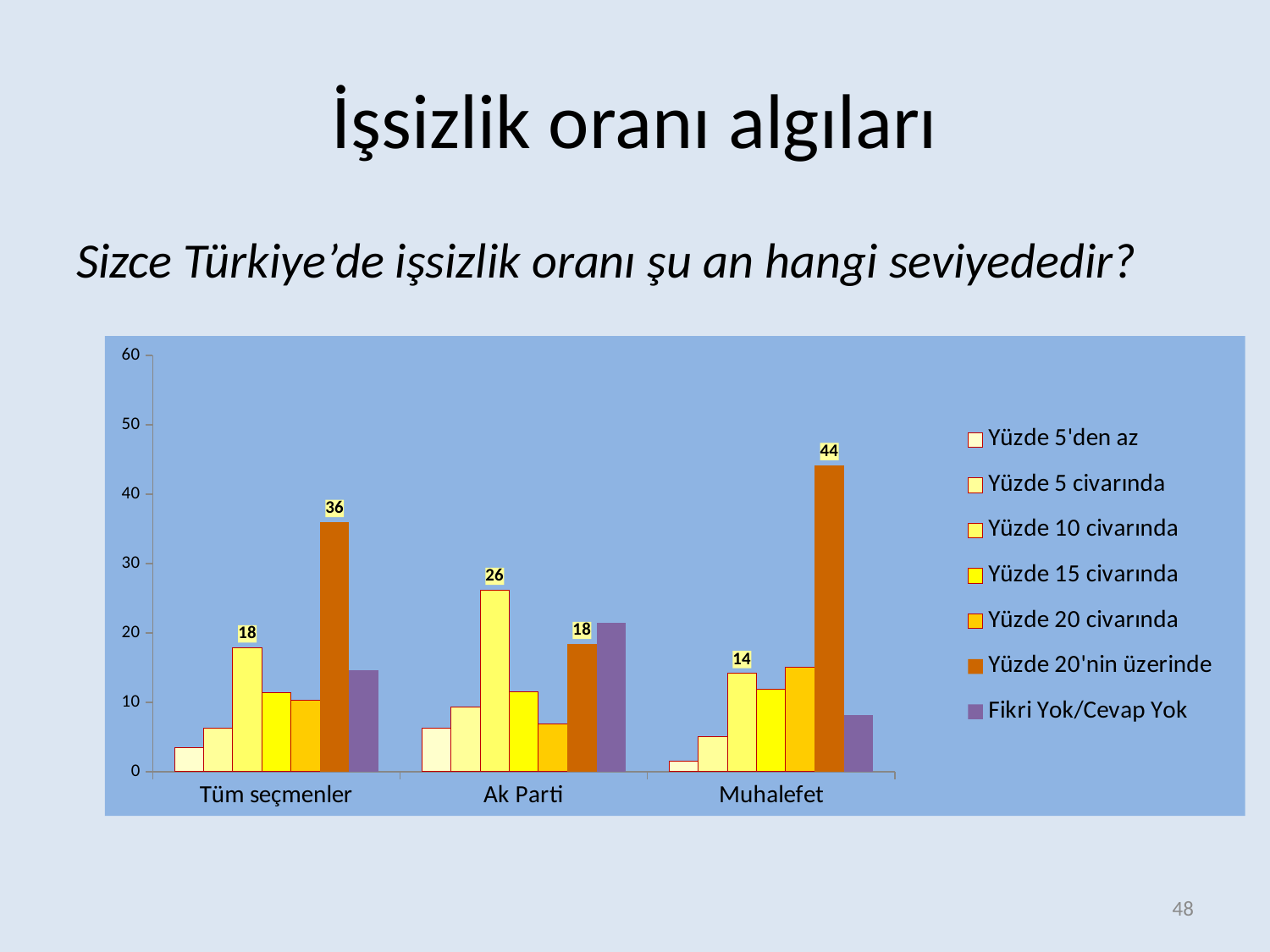
Which series is shown in purple in the legend? Fikri Yok/Cevap Yok What is the difference between the 'Yüzde 20'nin üzerinde' values for Muhalefet and Tüm seçmenler? 8 How many categories are shown on the x axis? 3 Which category has the lowest value for 'Yüzde 10 civarında'? Muhalefet Which category has the highest value for 'Yüzde 20'nin üzerinde'? Muhalefet In the Ak Parti group, which is larger: 'Yüzde 10 civarında' or 'Yüzde 20'nin üzerinde'? Yüzde 10 civarında How many series does the legend list? 7 What type of chart is shown on the slide? bar chart What is the value for 'Yüzde 20'nin üzerinde' in the Muhalefet group? 44 What is the value for 'Yüzde 20'nin üzerinde' in the Tüm seçmenler group? 36 What is the value for 'Yüzde 10 civarında' in the Ak Parti group? 26 Is the value for 'Fikri Yok/Cevap Yok' in the Muhalefet group greater or less than 10? less